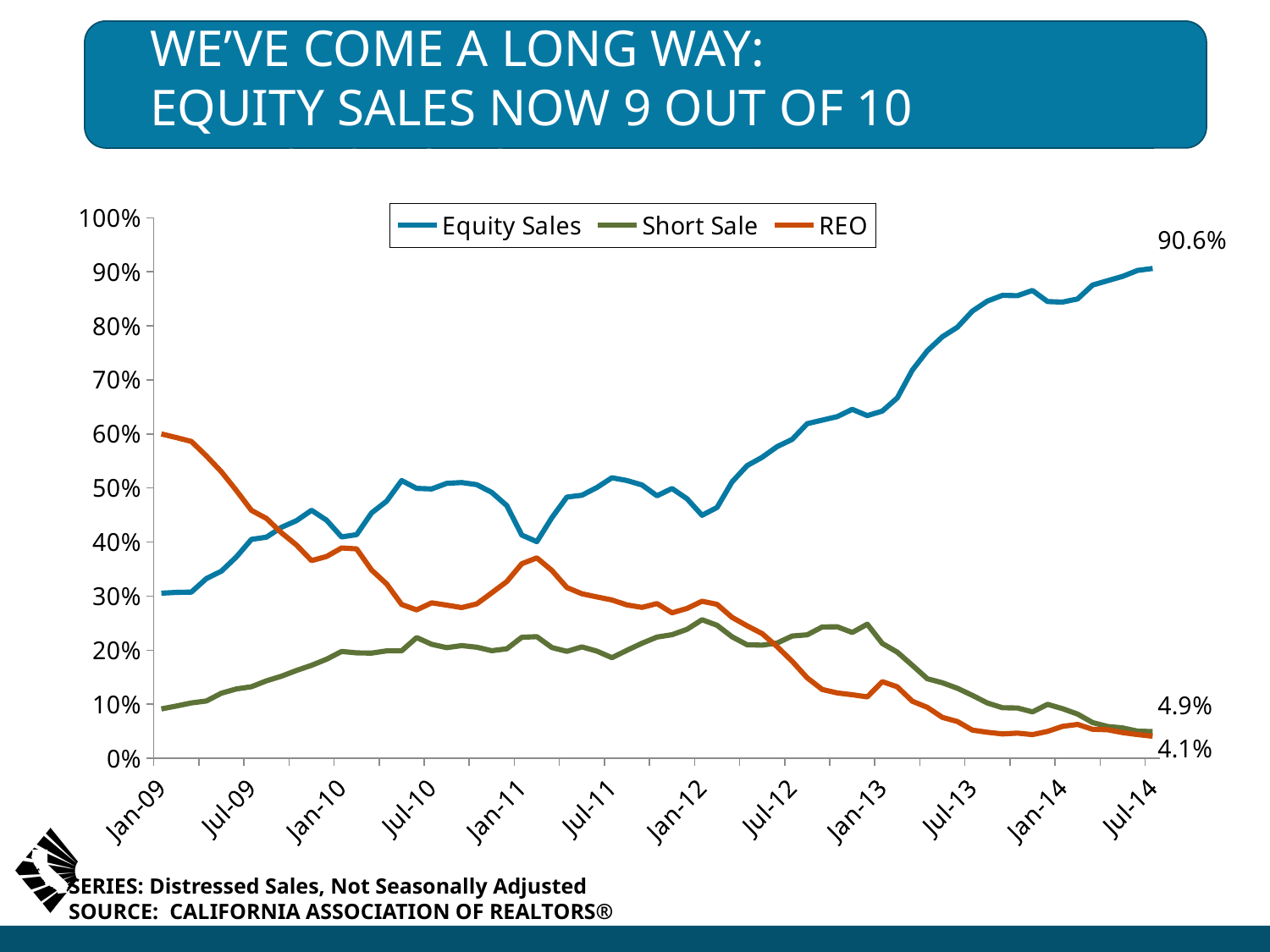
How many series does the legend list? 3 What is the value of REO at Jul-14? 4.1% Which series has the highest value at Jan-09? REO Is the value for Equity Sales at Jan-09 greater or less than 40%? less What is the value of Short Sale at Jul-14? 4.9% What kind of chart is shown on the slide? line chart At Jul-14, which is larger: Short Sale or REO? Short Sale What is the difference between Equity Sales and Short Sale at Jul-14? 85.7% Which series has the highest value at Jul-14? Equity Sales What is the value of Equity Sales at Jul-14? 90.6% Is the value for REO at Jan-09 greater or less than 50%? greater Does the REO series rise or fall from Jan-09 to Jul-14? fall